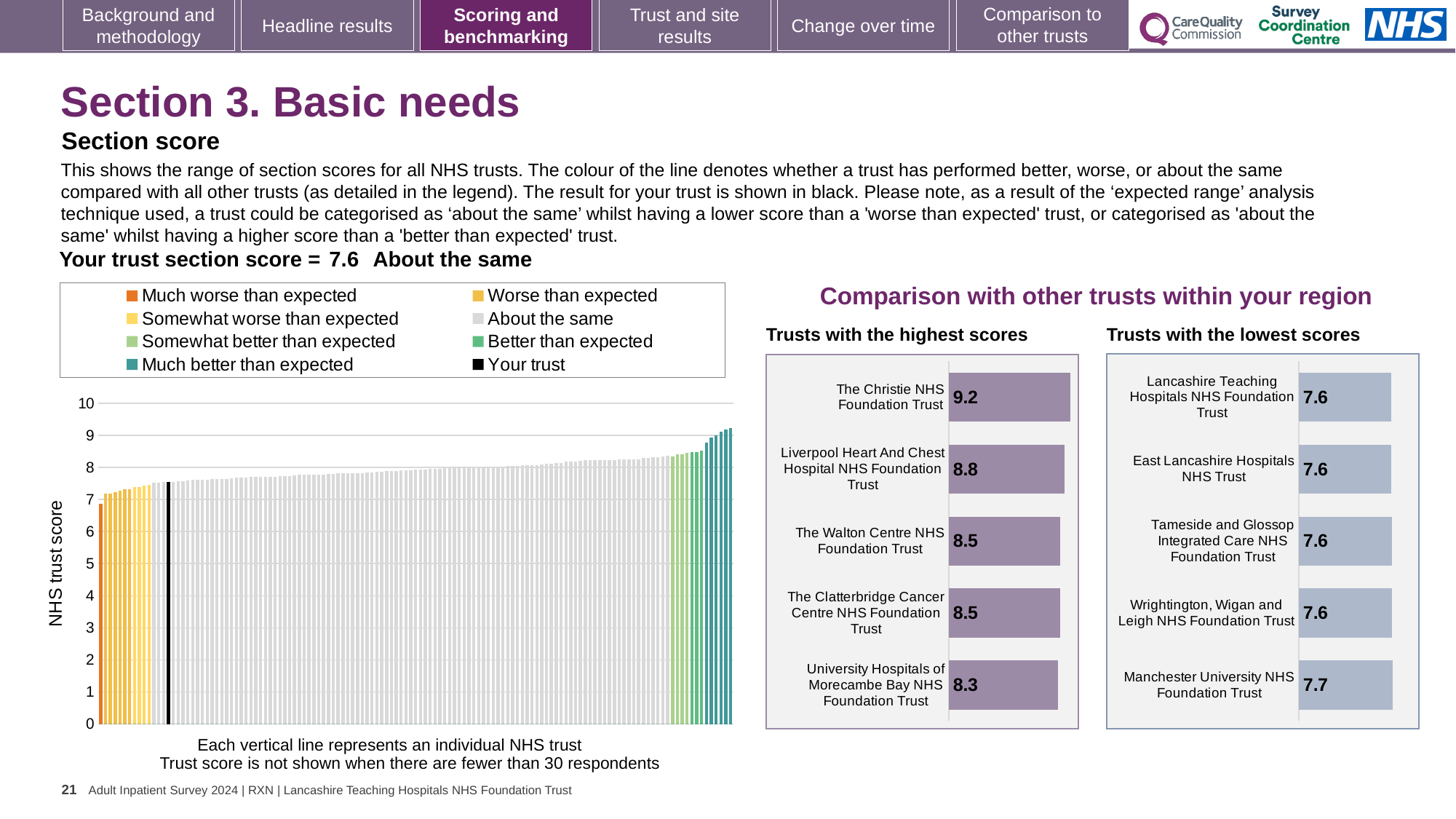
In the 'Trusts with the highest scores' chart, what is the score for The Christie NHS Foundation Trust? 9.2 In the 'Trusts with the highest scores' chart, what is the difference between the scores of The Christie NHS Foundation Trust and Liverpool Heart And Chest Hospital NHS Foundation Trust? 0.4 In the 'Trusts with the highest scores' chart, which trust has the highest score? The Christie NHS Foundation Trust In the 'Trusts with the highest scores' chart, what is the score for University Hospitals of Morecambe Bay NHS Foundation Trust? 8.3 In the 'Trusts with the lowest scores' chart, is the score for Manchester University NHS Foundation Trust larger or smaller than the score for Wrightington, Wigan and Leigh NHS Foundation Trust? larger How many entries does the legend of the large chart on the left list? 8 In the 'Trusts with the lowest scores' chart, which trust has the highest score? Manchester University NHS Foundation Trust In the 'Trusts with the highest scores' chart, how many trusts are shown? 5 What kind of chart is the large chart on the left showing NHS trust scores? bar chart In the 'Trusts with the lowest scores' chart, what is the score for Manchester University NHS Foundation Trust? 7.7 In the 'Trusts with the lowest scores' chart, what is the score for East Lancashire Hospitals NHS Trust? 7.6 In the large chart on the left, is the value for the black 'Your trust' bar greater or less than 8? less